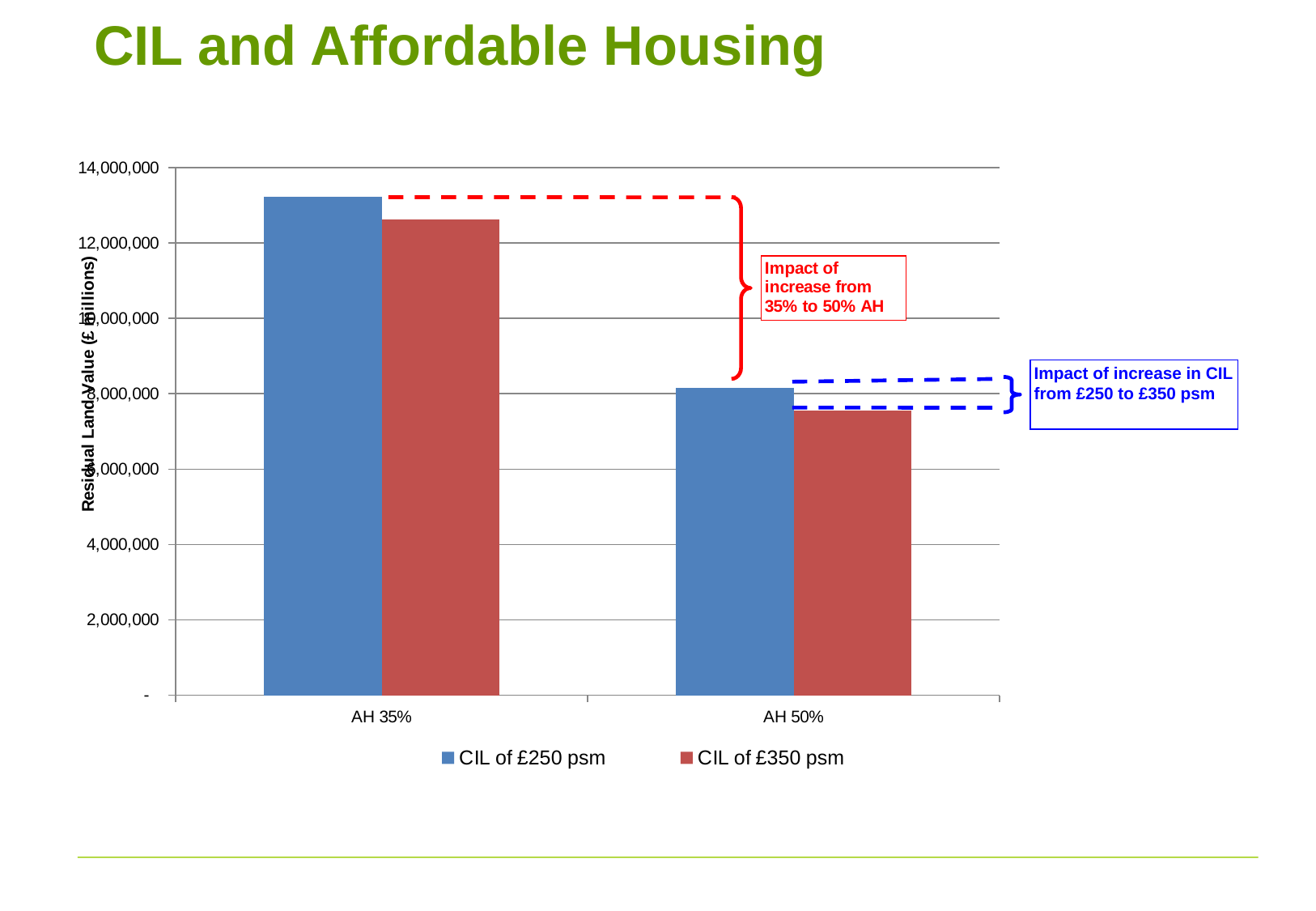
What kind of chart is shown on the slide? bar chart Which category and series has the highest bar in the chart? AH 35%, CIL of £250 psm For the AH 50% category, which series has the larger value, CIL of £250 psm or CIL of £350 psm? CIL of £250 psm Is the value for CIL of £250 psm at AH 35% greater or less than 12,000,000? greater Which category and series has the lowest bar in the chart? AH 50%, CIL of £350 psm Is the value for CIL of £250 psm at AH 50% greater or less than 10,000,000? less How many categories are shown on the x axis of the chart? 2 Which colour represents the CIL of £350 psm series in the chart? red How many series does the chart's legend list? 2 Do the values for the CIL of £350 psm series rise or fall from AH 35% to AH 50%? fall Is the value for CIL of £350 psm at AH 50% greater or less than 8,000,000? less For the CIL of £250 psm series, which category has the larger value, AH 35% or AH 50%? AH 35%